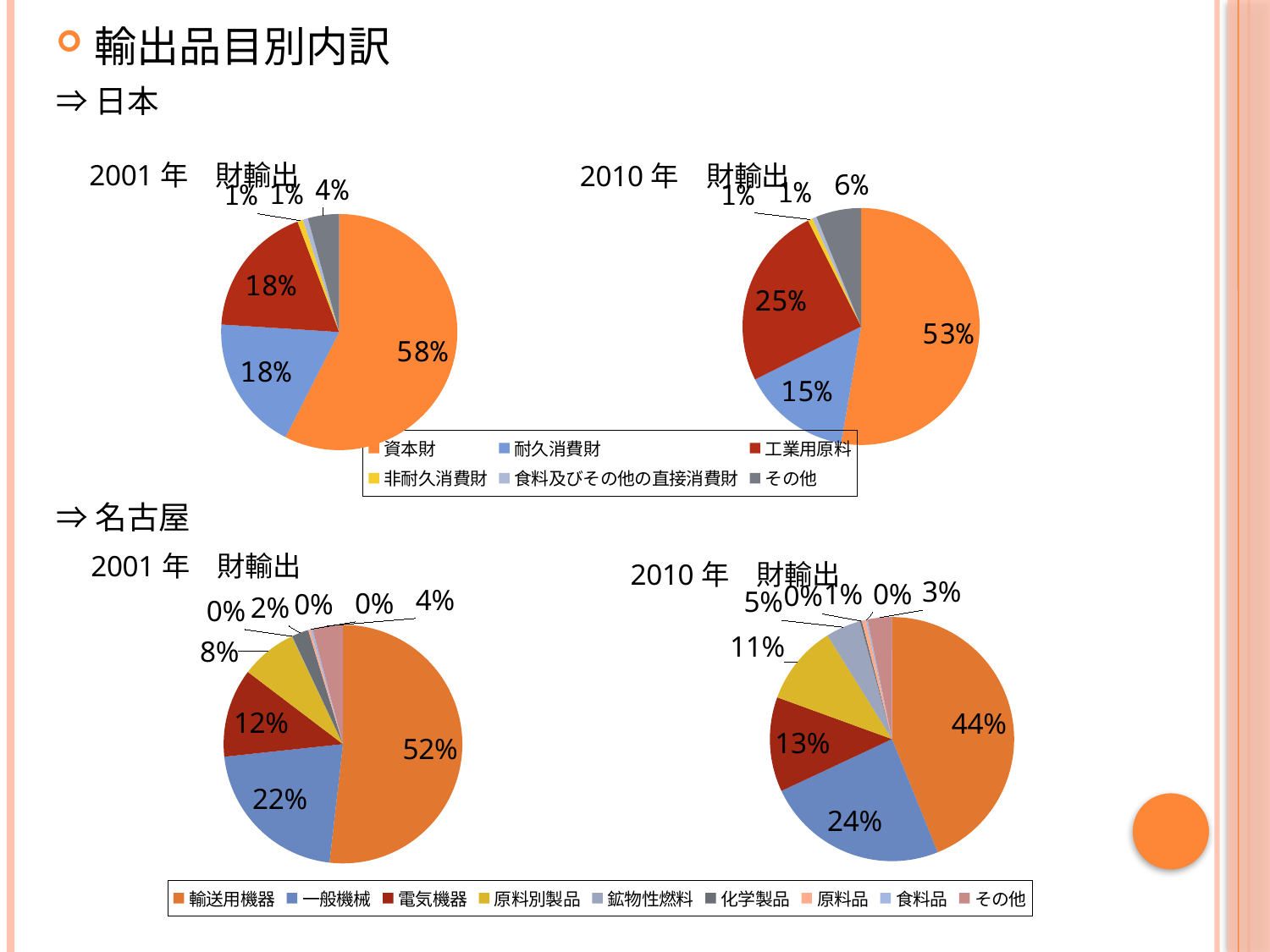
In the 日本 2010年 財輸出 chart, what share does 耐久消費財 have? 15% In the 名古屋 2001年 財輸出 chart, what share does 一般機械 have? 22% In the 名古屋 2010年 財輸出 chart, what share does 原料別製品 have? 11% What kind of chart is used for the 日本 2001年 財輸出 data? Pie chart In the 名古屋 2001年 財輸出 chart, which category has the largest slice? 輸送用機器 In the 名古屋 2010年 財輸出 chart, what share does 輸送用機器 have? 44% In the 名古屋 2010年 財輸出 chart, which is larger, 電気機器 or 一般機械? 一般機械 How many series does the legend of the 名古屋 charts list? 9 In the 日本 2010年 財輸出 chart, which category has the largest slice? 資本財 In the 日本 2001年 財輸出 chart, what share does 資本財 have? 58% In the 日本 2010年 財輸出 chart, what is the difference between the shares of 工業用原料 and 耐久消費財? 10% In the 日本 2010年 財輸出 chart, what share does 工業用原料 have? 25%